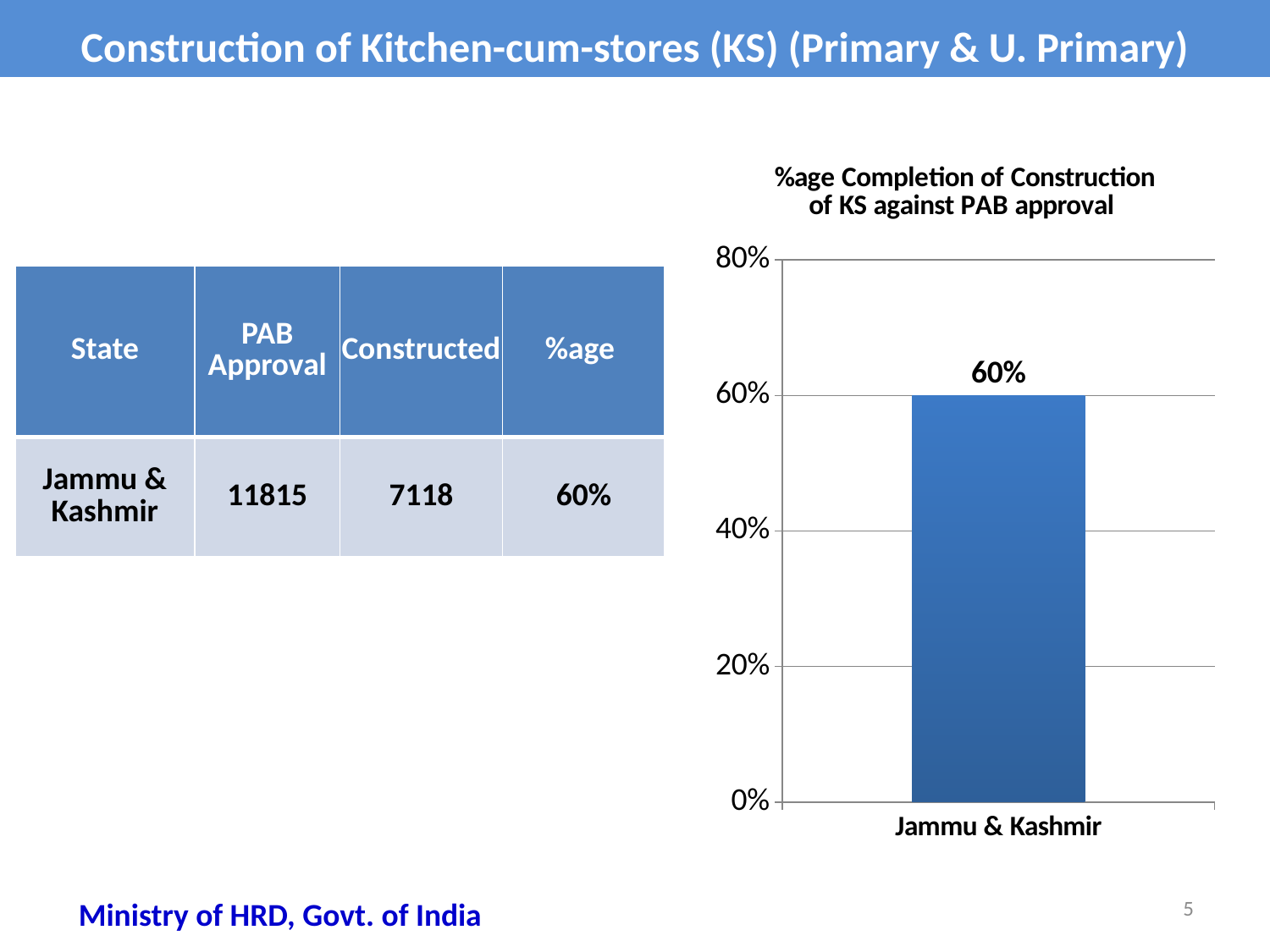
Which category is labelled on the x axis of the chart? Jammu & Kashmir Is the value for Jammu & Kashmir greater or less than 80%? less How many categories are plotted in the chart? 1 What is the title of the chart? %age Completion of Construction of KS against PAB approval What is the highest value shown on the chart's vertical axis? 80% What is the value shown for Jammu & Kashmir in the chart? 60% What kind of chart is shown on the slide? bar chart Is the value for Jammu & Kashmir greater or less than 40%? greater